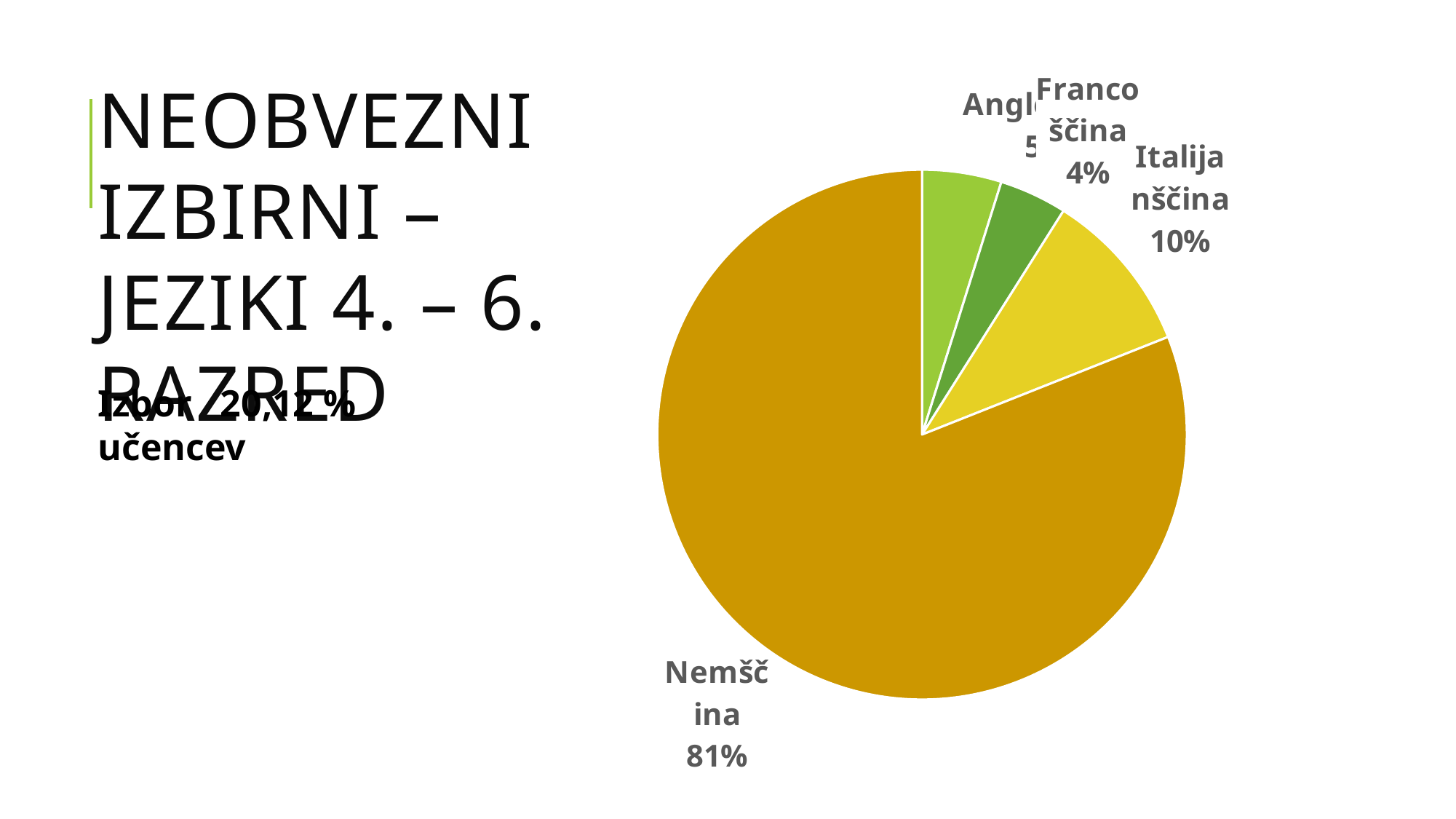
What kind of chart is shown on the slide? pie chart How many slices does the pie chart have? 4 How many percentage points larger is the Italijanščina share than the Francoščina share? 6 percentage points What share of the pie does Nemščina have? 81% How many percentage points larger is the Nemščina share than the Italijanščina share? 71 percentage points What colour is the Nemščina slice of the pie? gold What share of the pie does Italijanščina have? 10% Which is larger, the slice for Italijanščina or the slice for Francoščina? Italijanščina Which language has the largest slice of the pie? Nemščina What share of the pie does Francoščina have? 4% Which is larger, the slice for Nemščina or the slice for Italijanščina? Nemščina